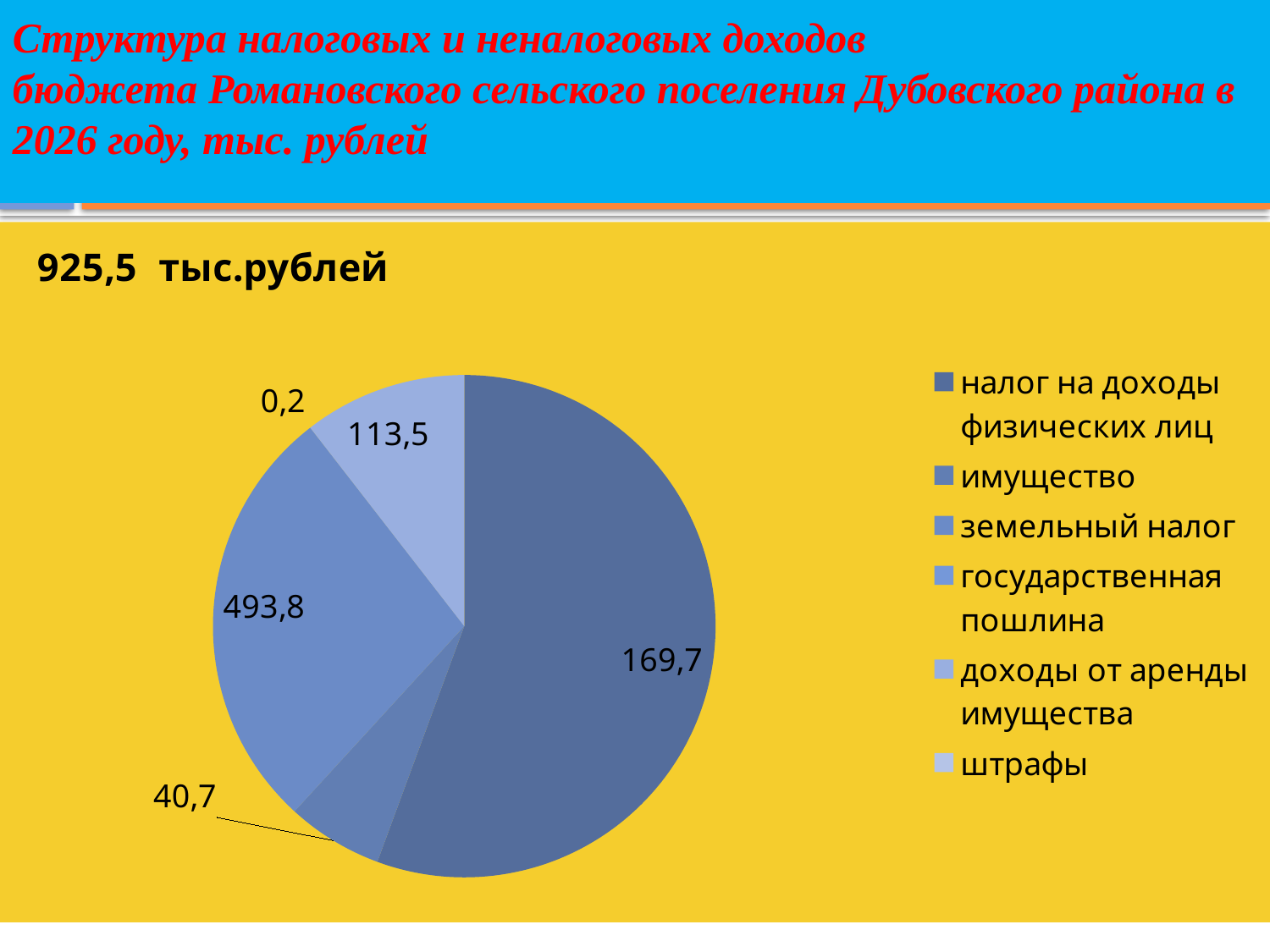
What kind of chart is shown on the slide? pie chart What is the largest value printed as a data label on the pie chart? 493,8 Which legend entry is listed first in the pie chart's legend? налог на доходы физических лиц What is the smallest value printed as a data label on the pie chart? 0,2 What total amount is printed above the pie chart? 925,5 тыс.рублей Which data label on the pie chart is connected to its slice by a leader line? 40,7 How many categories does the legend of the pie chart list? 6 What is the difference between the printed values 493,8 and 169,7 on the pie chart? 324,1 Which printed value is larger on the pie chart, 113,5 or 169,7? 169,7 For which year does the slide title say the revenue structure is shown? 2026 How many data labels are printed on the pie chart? 5